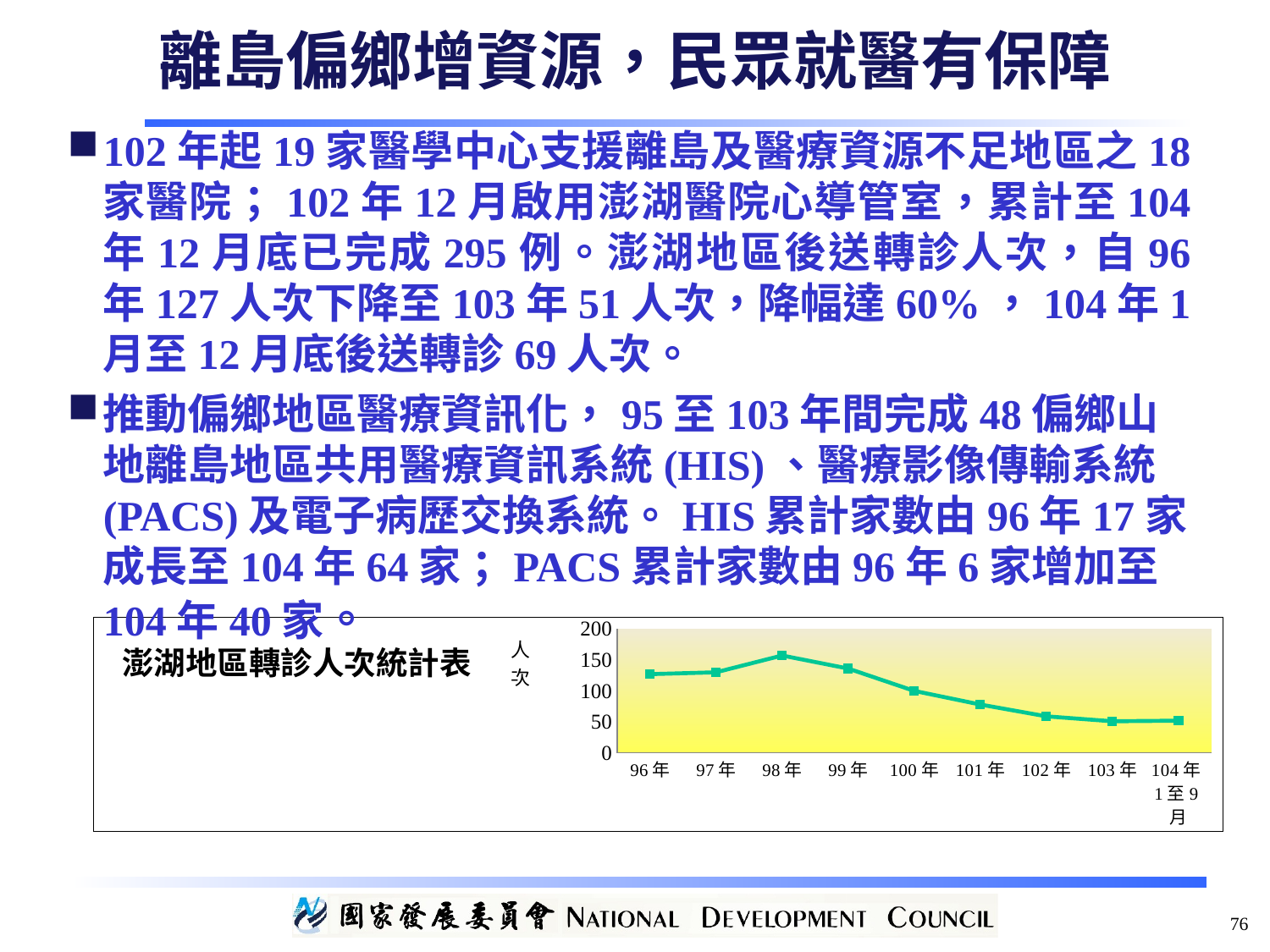
What kind of chart is shown on the slide? line chart Which is larger, the value for 98年 or the value for 100年? 98年 What is the title of the chart on the slide? 澎湖地區轉診人次統計表 Which is larger, the value for 96年 or the value for 102年? 96年 What is the label on the vertical axis of the chart? 人次 How many data points are plotted on the line in the chart? 9 Is the value for 96年 greater or less than 100? greater Is the value for 102年 greater or less than 100? less Is the value for 99年 greater or less than 150? less Which year has the highest value in the chart? 98年 Overall, do the values rise or fall from 98年 to 103年? fall